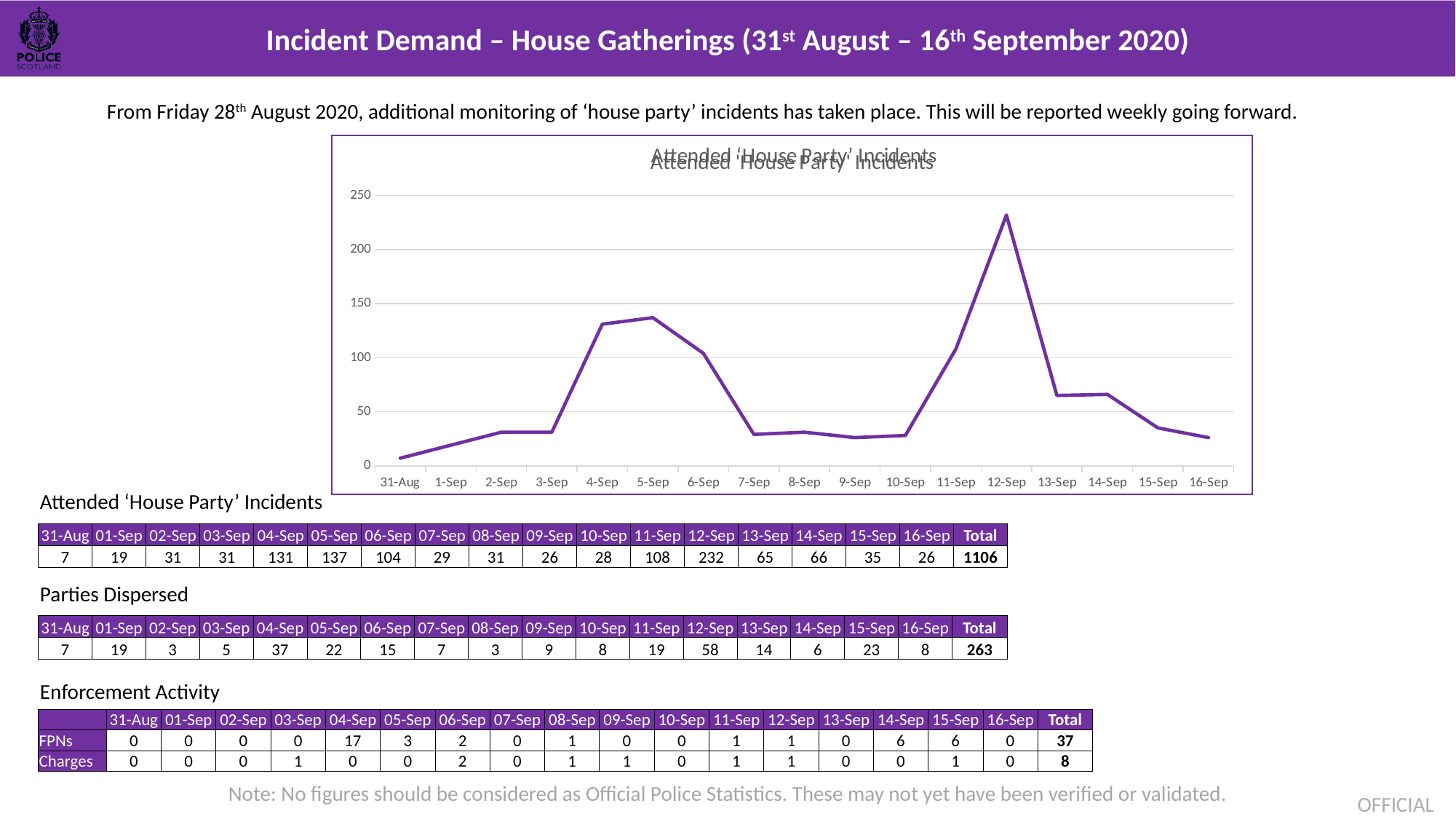
On which date does the chart reach its highest value? 12-Sep What is the title of the chart? Attended 'House Party' Incidents Is the value for 7-Sep greater or less than 50? less On which date does the chart show its lowest value? 31-Aug Do the values rise or fall between 12-Sep and 16-Sep? fall How many dates are plotted along the x axis of the chart? 17 What kind of chart is shown on the slide? line chart Is the value for 5-Sep greater or less than 100? greater Is the value for 12-Sep greater or less than 200? greater Which date has the higher value, 4-Sep or 6-Sep? 4-Sep According to the slide, how many attended 'House Party' incidents were there on 12-Sep? 232 What is the difference between the attended incidents on 12-Sep and 11-Sep, as printed on the slide? 124